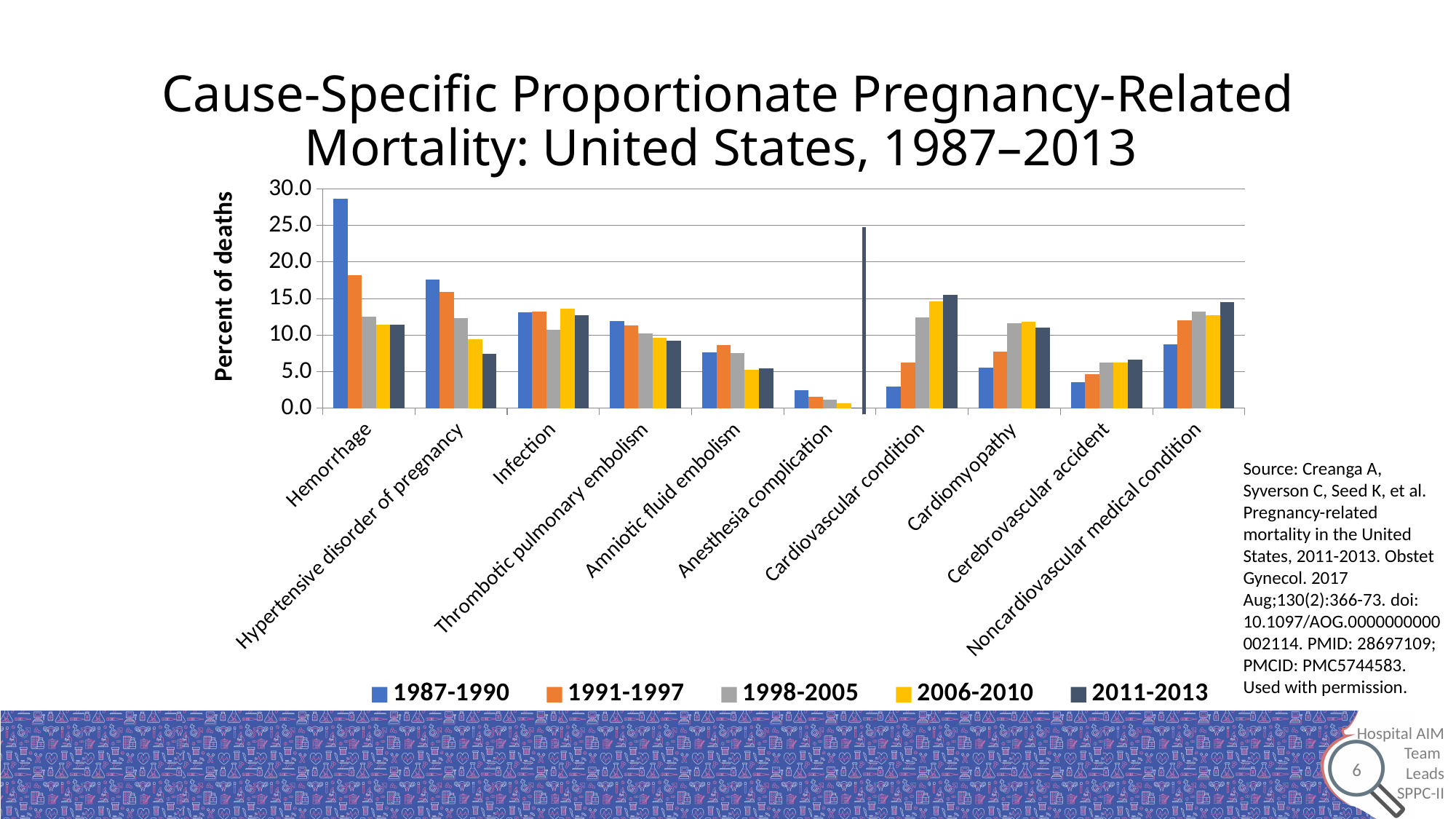
How many cause categories are shown on the x axis? 10 For the 2011-2013 series, which is larger: Cardiovascular condition or Cardiomyopathy? Cardiovascular condition For the 1987-1990 series, which is larger: Hemorrhage or Hypertensive disorder of pregnancy? Hemorrhage What kind of chart is shown on the slide? bar chart Is the 2006-2010 value for Infection greater or less than 10.0? greater What is the label of the y axis? Percent of deaths Is the 1987-1990 value for Hemorrhage greater or less than 25.0? greater Do the values for Cardiovascular condition rise or fall from the 1987-1990 series to the 2011-2013 series? rise Is the 1987-1990 value for Cardiovascular condition greater or less than 5.0? less Which cause has the lowest value for the 2011-2013 series? Anesthesia complication How many series does the legend list? 5 Which cause has the highest value for the 1987-1990 series? Hemorrhage